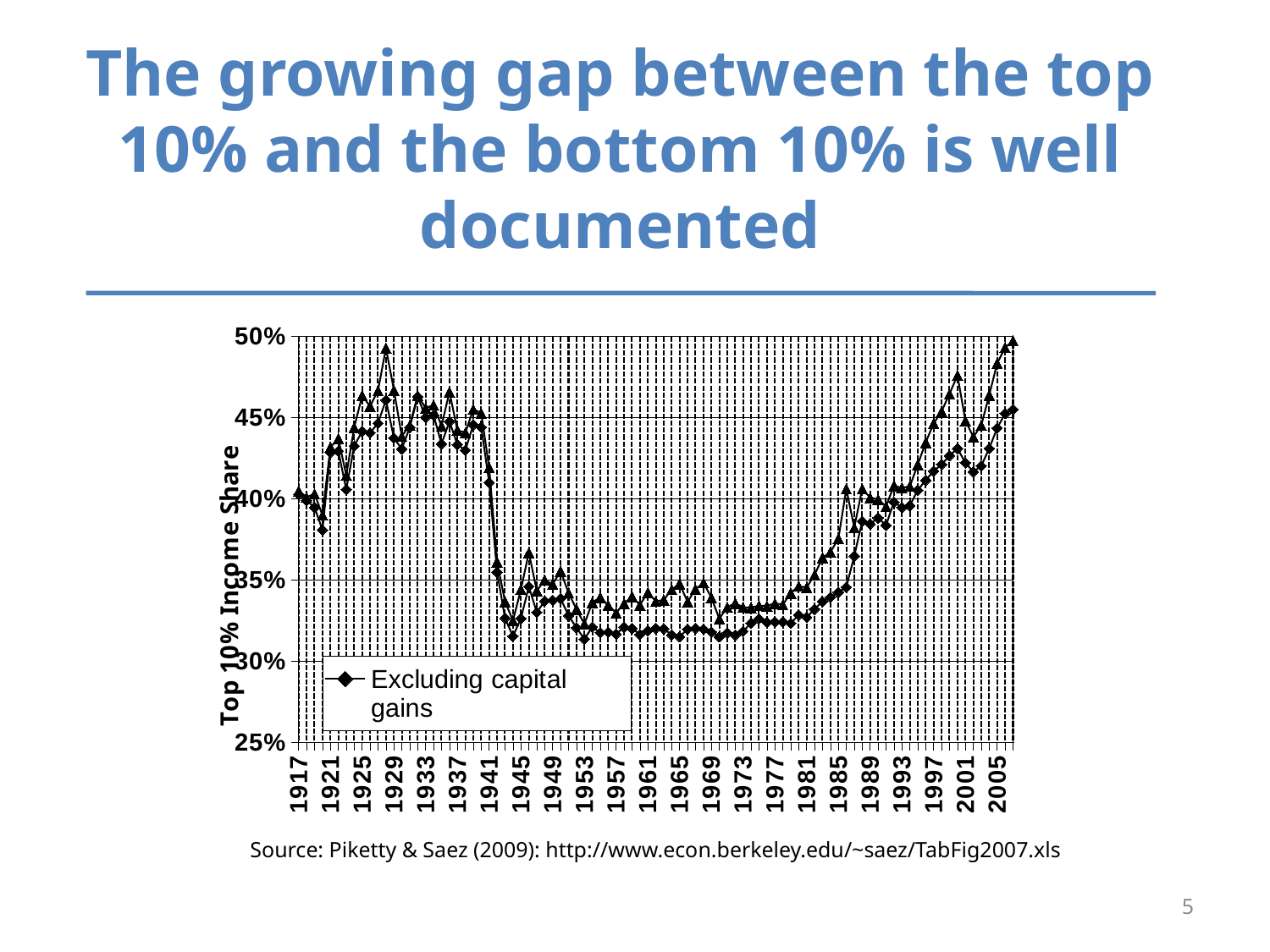
What is the title of the vertical axis? Top 10% Income Share In 2005, is the triangle-marker series above or below the Excluding capital gains series? above Is the value for Excluding capital gains in 1917 greater or less than 45%? less Is the value for Excluding capital gains in 1929 greater or less than 40%? greater What is the first year labeled on the horizontal axis? 1917 Is the value for Excluding capital gains in 1973 greater or less than 35%? less Between 1941 and 1945, does the Excluding capital gains series rise or fall? fall Between 1985 and 2005, does the Excluding capital gains series rise or fall? rise How many series does the chart legend list? 1 What kind of chart is shown on the slide? line chart